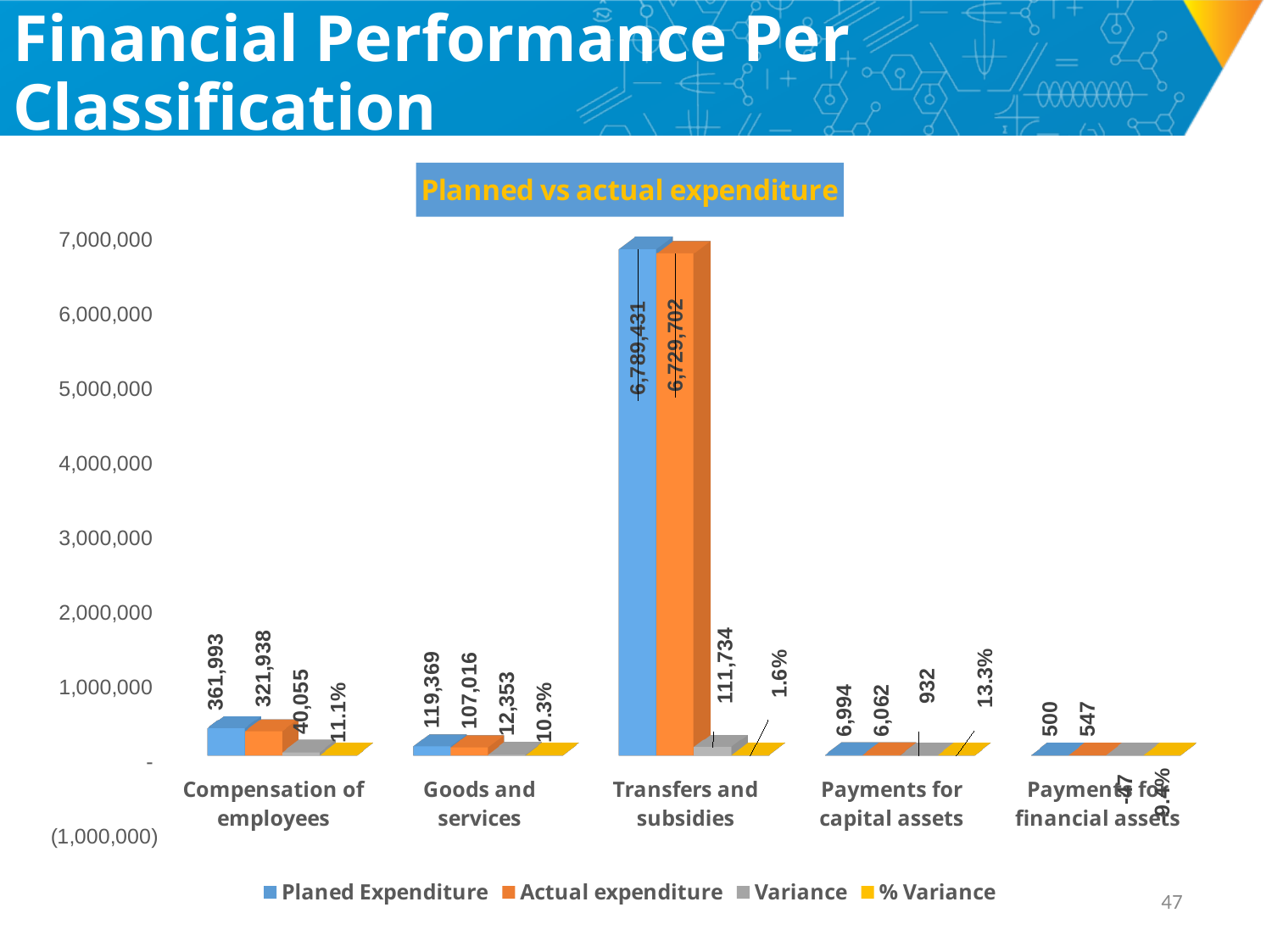
How many series does the legend list? 4 What is the Variance value for Payments for capital assets? 932 How many categories are shown on the x axis? 5 What is the difference between Planed Expenditure and Actual expenditure for Compensation of employees? 40,055 What is the Actual expenditure value for Goods and services? 107,016 What is the Actual expenditure value for Transfers and subsidies? 6,729,702 For Payments for financial assets, which is larger: Planed Expenditure or Actual expenditure? Actual expenditure What type of chart is shown on the slide? Bar chart Which category has the highest Planed Expenditure? Transfers and subsidies What is the Planed Expenditure value for Compensation of employees? 361,993 Which category has the lowest Actual expenditure? Payments for financial assets What is the % Variance for Goods and services? 10.3%